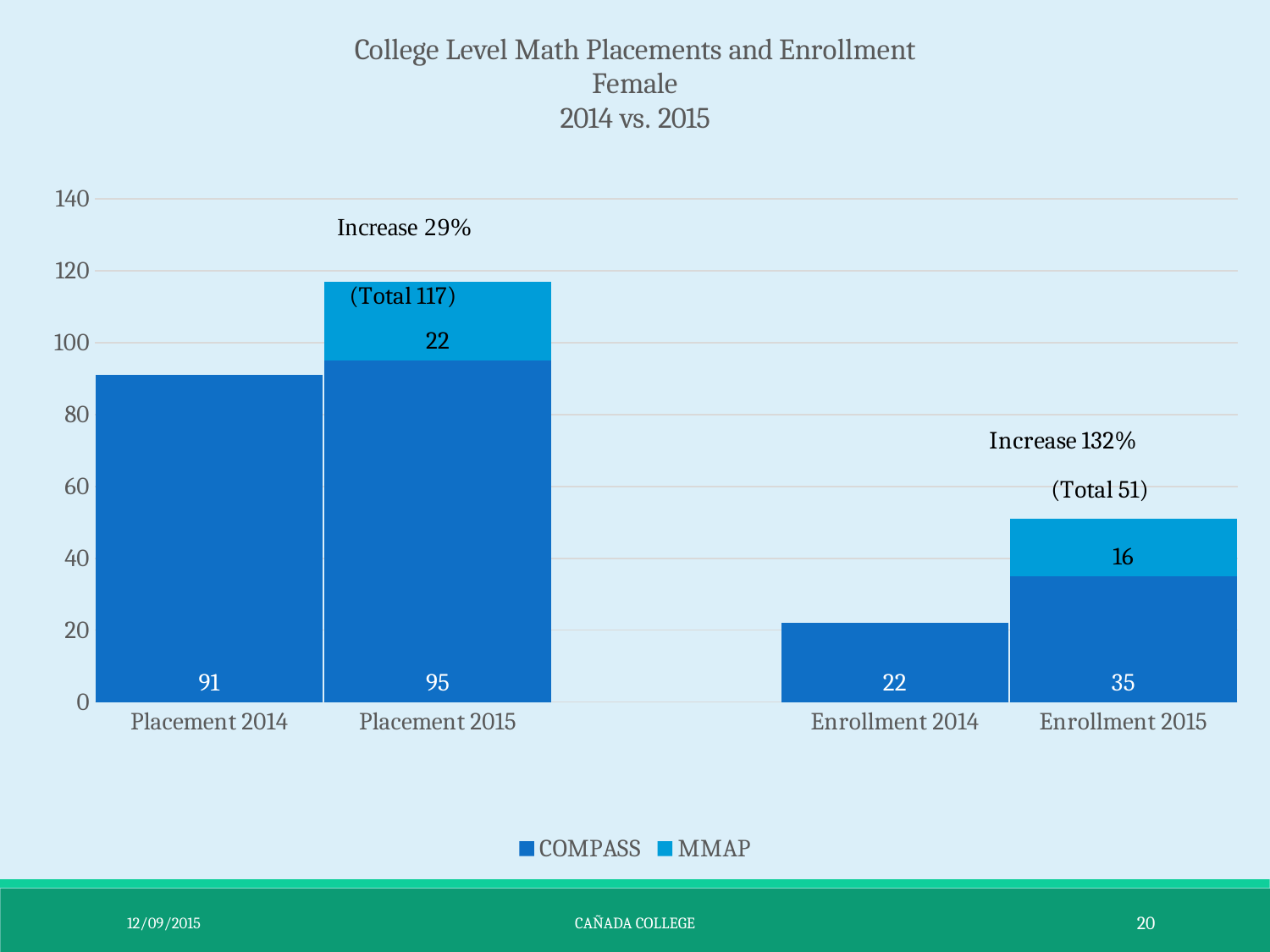
What is the COMPASS value for Placement 2014? 91 What is the total of the stacked bar for Placement 2015? 117 What is the difference between the COMPASS values for Enrollment 2015 and Enrollment 2014? 13 Is the COMPASS value for Enrollment 2014 larger or smaller than the COMPASS value for Enrollment 2015? smaller Which category has the lowest COMPASS value? Enrollment 2014 What is the COMPASS value for Enrollment 2015? 35 What is the total of the stacked bar for Enrollment 2015? 51 How many series does the legend list? 2 What percentage increase is shown for enrollment from 2014 to 2015? 132% What is the difference between the COMPASS values for Placement 2015 and Placement 2014? 4 What is the MMAP value for Placement 2015? 22 What is the MMAP value for Enrollment 2015? 16